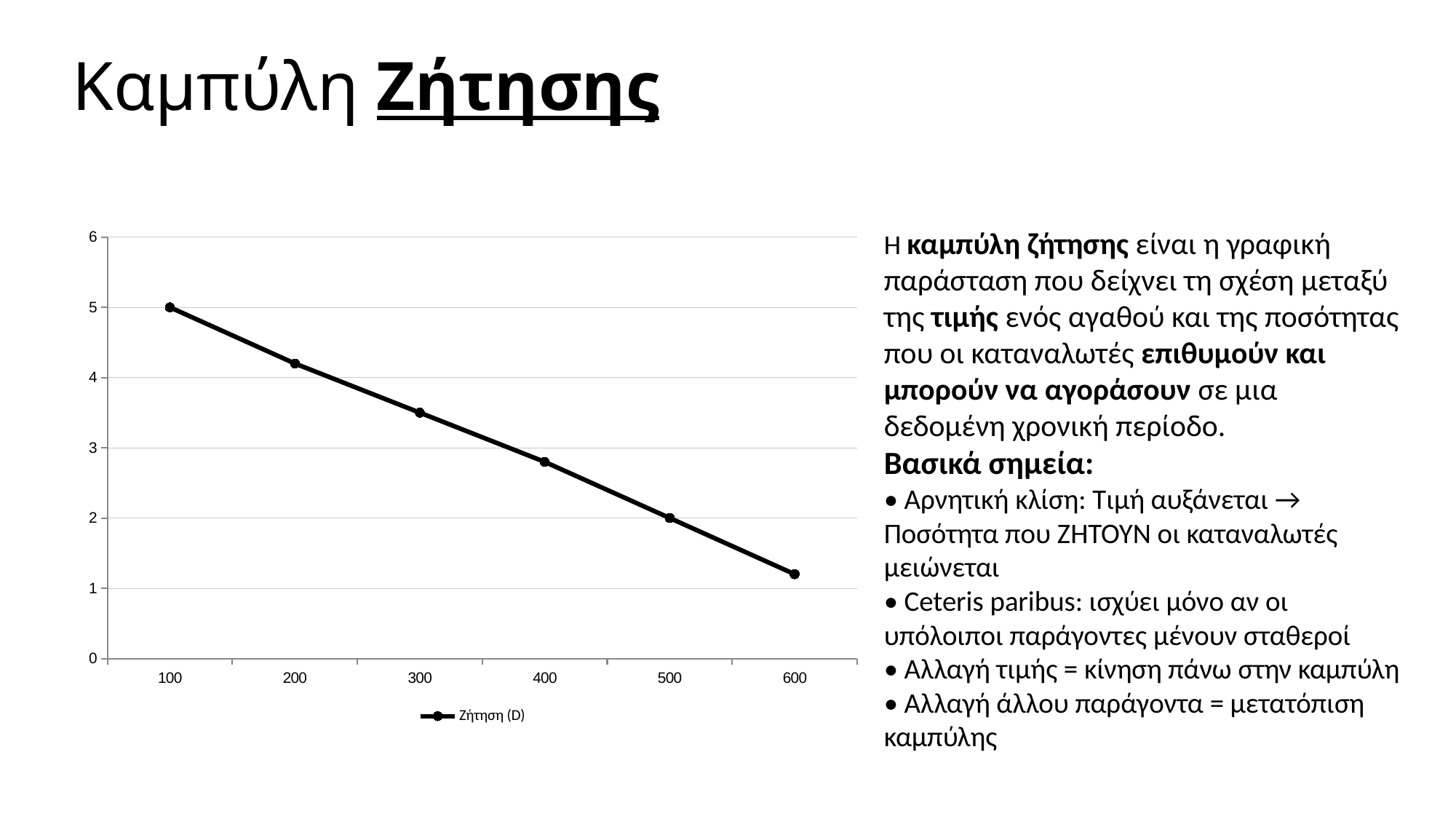
How many data points are plotted on the line? 6 Which has the larger value, 300 or 600? 300 Do the values rise or fall as the x axis goes from 100 to 600? fall What kind of chart is shown on the slide? line chart How many series does the legend list? 1 At which x-axis category is the value of Ζήτηση (D) highest? 100 Is the value for 400 greater or less than 3? less What is the name of the series shown in the legend? Ζήτηση (D) At which x-axis category is the value of Ζήτηση (D) lowest? 600 What is the value of Ζήτηση (D) at 500? 2 Is the value for 200 greater or less than 4? greater What is the value of Ζήτηση (D) at 100? 5